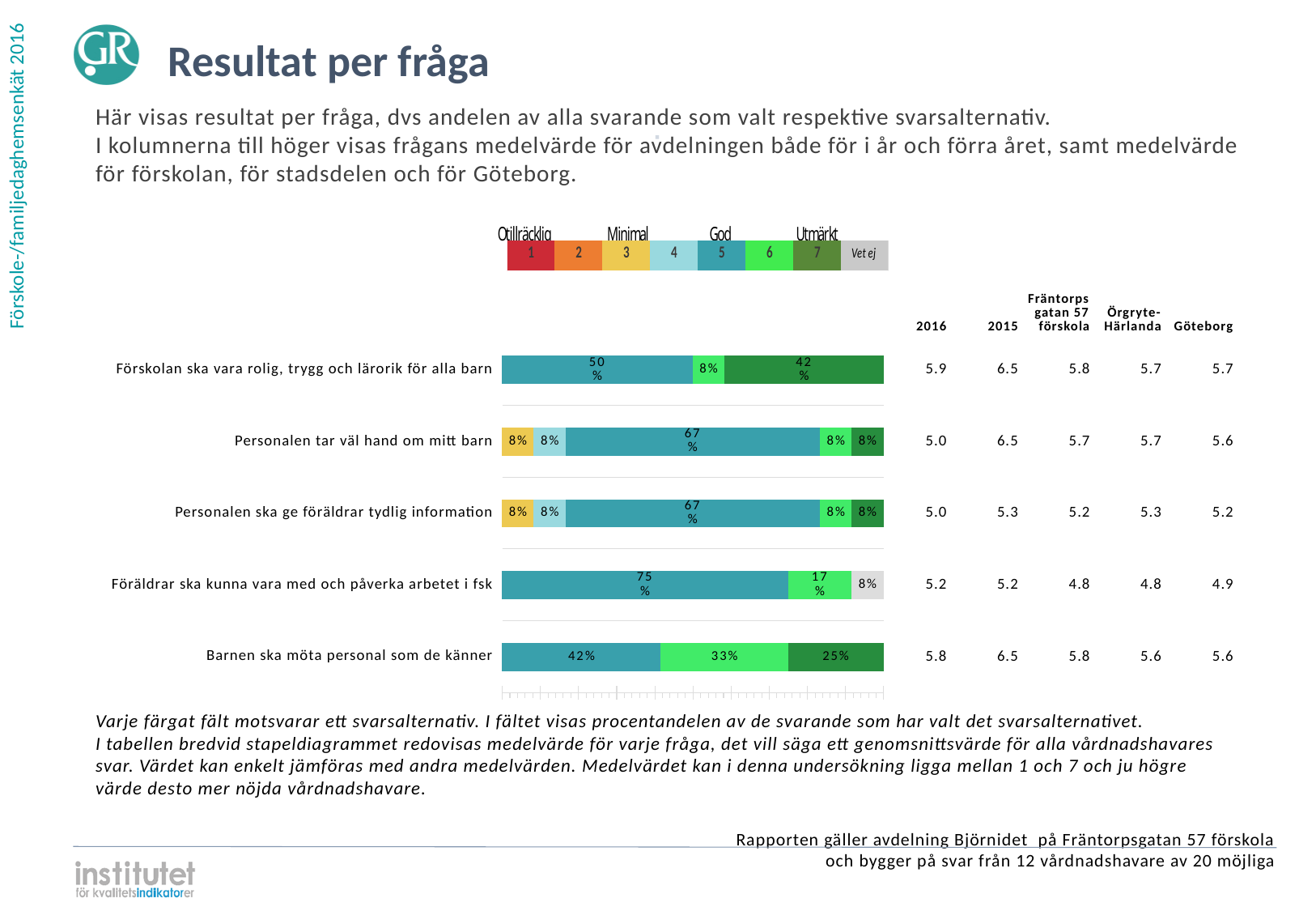
What is the total of the three segments in the bar for "Barnen ska möta personal som de känner"? 100% What share of respondents chose answer 7 (Utmärkt) for "Förskolan ska vara rolig, trygg och lärorik för alla barn"? 42% What is the largest segment in the bar for "Föräldrar ska kunna vara med och påverka arbetet i fsk"? 75% What is the 2016 mean value shown for "Förskolan ska vara rolig, trygg och lärorik för alla barn"? 5.9 What is the "Vet ej" share for "Föräldrar ska kunna vara med och påverka arbetet i fsk"? 8% Which is larger: the answer-6 share for "Barnen ska möta personal som de känner" (33%) or for "Föräldrar ska kunna vara med och påverka arbetet i fsk" (17%)? Barnen ska möta personal som de känner For "Förskolan ska vara rolig, trygg och lärorik för alla barn", how many percentage points larger is the 50% segment than the 42% segment? 8 percentage points What percentage of respondents chose answer 5 (God) for "Barnen ska möta personal som de känner"? 42% How many questions (categories) are shown in the bar chart? 5 What kind of chart is used to show the results per question? Stacked bar chart Which question has the largest single answer-option segment in its bar? Föräldrar ska kunna vara med och påverka arbetet i fsk What are the four scale labels shown above the colour legend? Otillräcklig, Minimal, God, Utmärkt